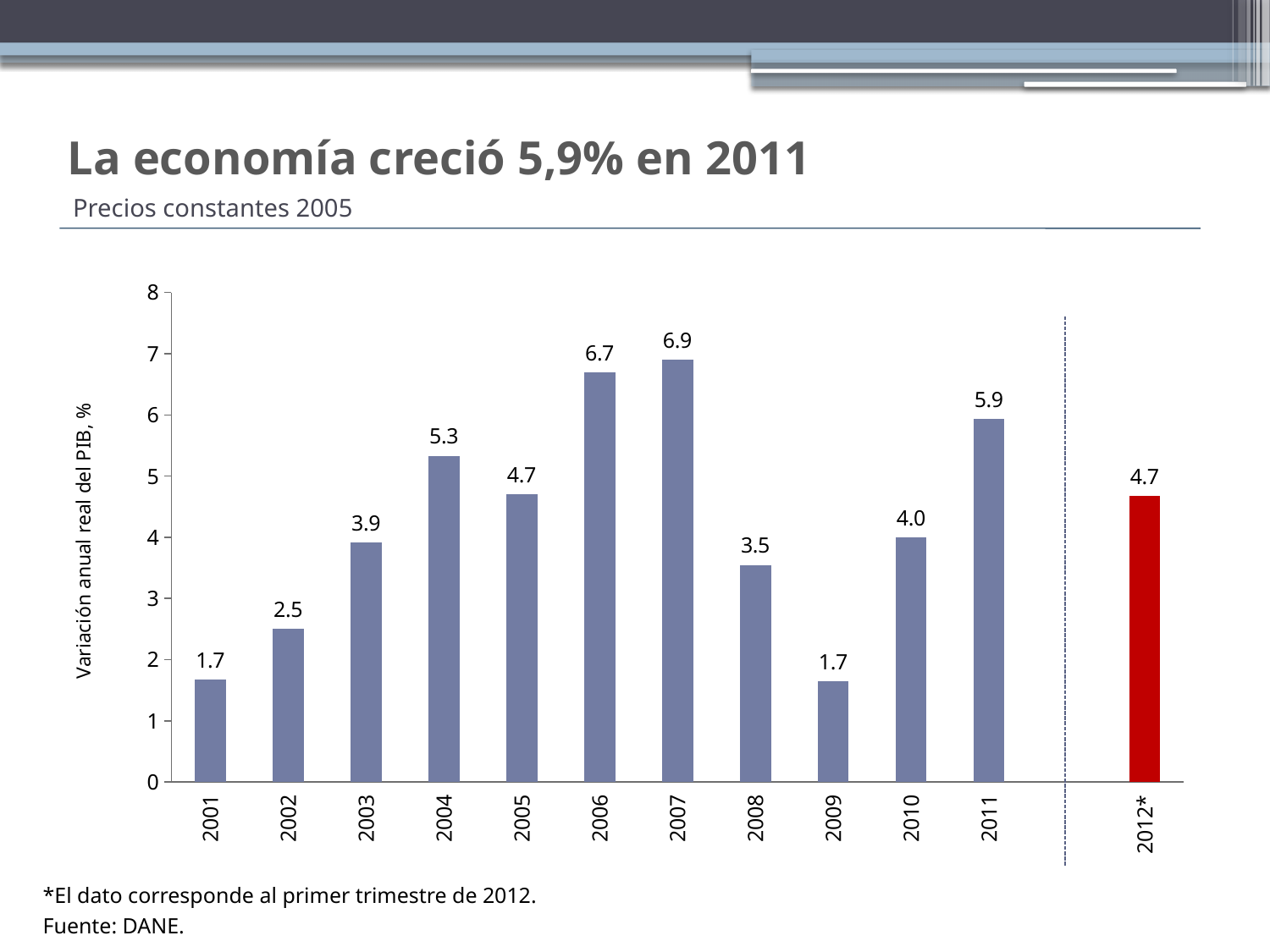
Which is larger, the value for 2004 or the value for 2005? 2004 Is the value for 2008 greater or less than 4? less What kind of chart is shown on the slide? bar chart How many bars are plotted in the chart? 12 What is the value for 2009? 1.7 What is the value for 2007? 6.9 Which bar is coloured red? 2012* Do the values rise or fall from 2007 to 2009? fall Which year has the highest value? 2007 What is the difference between the values for 2011 and 2010? 1.9 What is the label of the vertical axis? Variación anual real del PIB, % What is the value for 2012*? 4.7